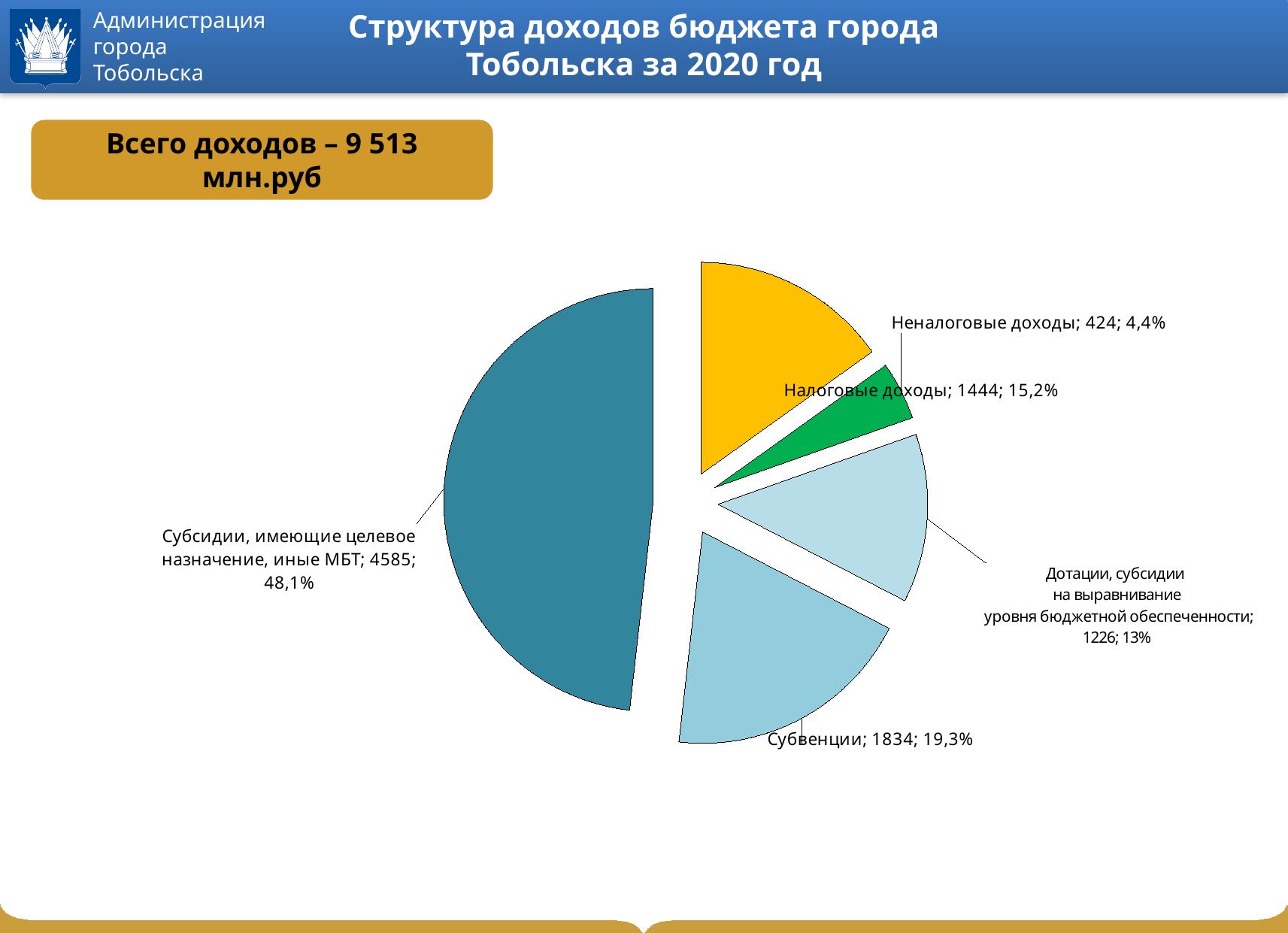
What share of the pie does "Неналоговые доходы" have? 4,4% Which is larger, the value for "Налоговые доходы" or for "Дотации, субсидии на выравнивание уровня бюджетной обеспеченности"? Налоговые доходы What value is shown for "Дотации, субсидии на выравнивание уровня бюджетной обеспеченности"? 1226 What share of the pie does "Субсидии, имеющие целевое назначение, иные МБТ" have? 48,1% What share of the pie does "Субвенции" have? 19,3% What total income is stated in the box on the slide? 9 513 млн.руб Which category has the smallest slice in the pie chart? Неналоговые доходы Which category has the largest slice in the pie chart? Субсидии, имеющие целевое назначение, иные МБТ What is the difference between the values for "Субвенции" and "Налоговые доходы"? 390 What kind of chart is shown on the slide? pie chart How many slices does the pie chart have? 5 What value is shown for "Налоговые доходы" in the pie chart? 1444